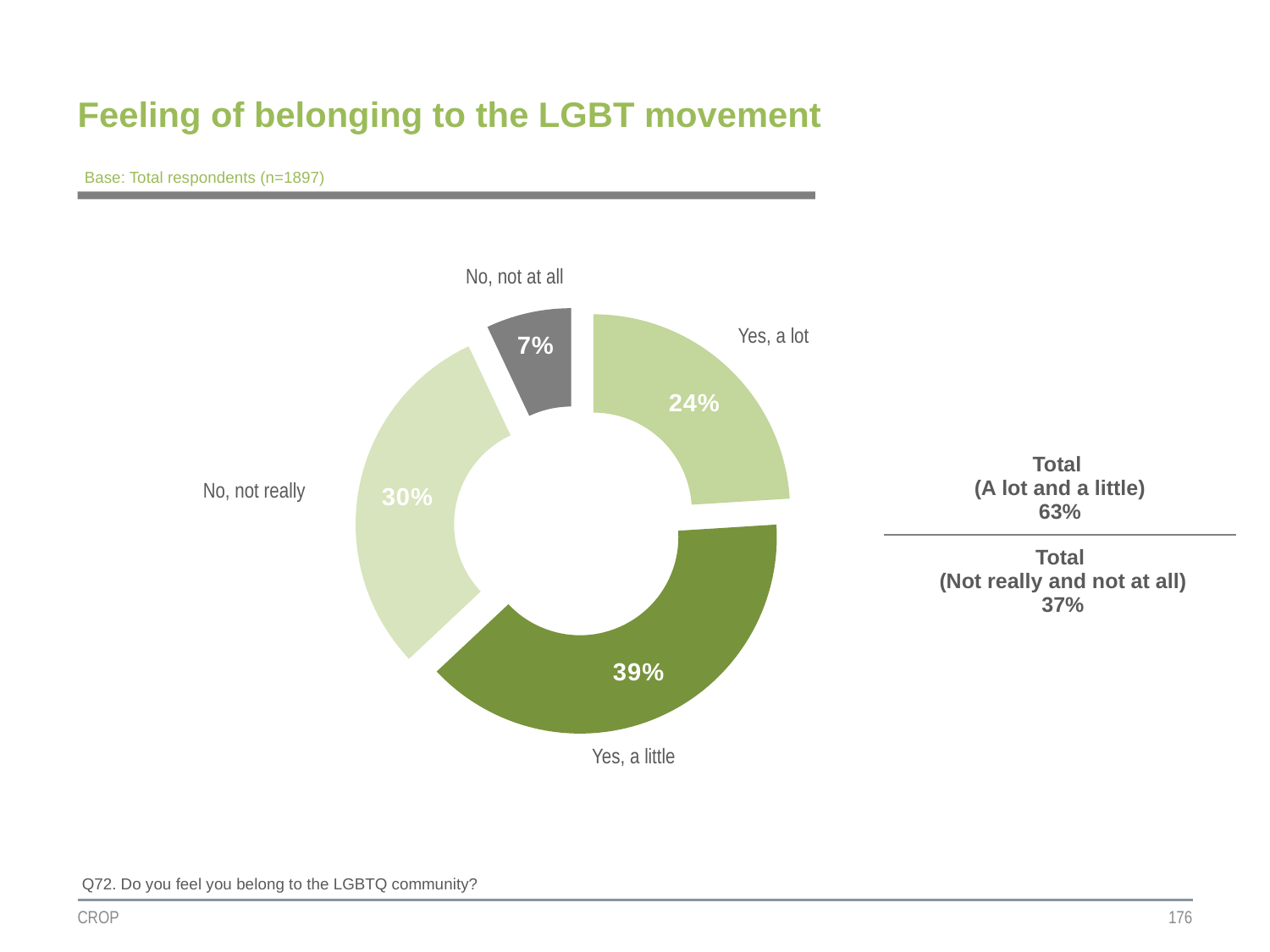
What percentage of respondents answered "Yes, a lot"? 24% What percentage of respondents answered "Yes, a little"? 39% What is the title of the chart? Feeling of belonging to the LGBT movement What is the difference in percentage points between "Yes, a little" and "Yes, a lot"? 15 Which is larger, the share for "No, not really" or the share for "Yes, a lot"? No, not really What is the combined total for "A lot and a little" shown on the slide? 63% Which response category has the largest share? Yes, a little What percentage of respondents answered "No, not at all"? 7% Which response category has the smallest share? No, not at all How many response categories are shown in the chart? 4 What kind of chart is shown on the slide? Doughnut chart What percentage of respondents answered "No, not really"? 30%